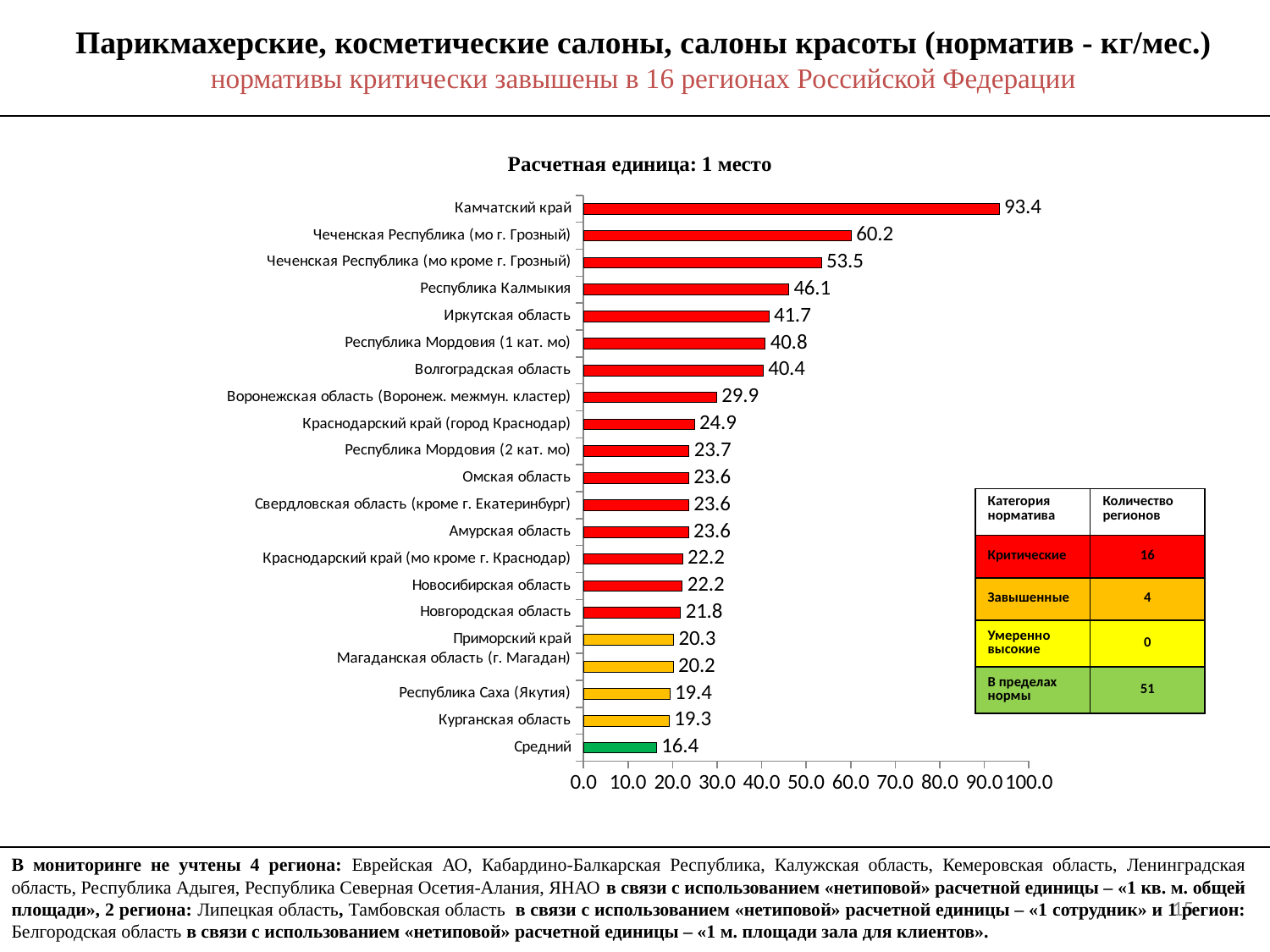
What is the value for Республика Калмыкия? 46.1 What is the value for Камчатский край? 93.4 How many bars are plotted in the chart? 21 Which category has the lowest value? Средний What is the title of the chart? Расчетная единица: 1 место What kind of chart is shown on the slide? bar chart What is the difference between the values for Камчатский край and Чеченская Республика (мо г. Грозный)? 33.2 What is the value for Средний? 16.4 Which is larger: the value for Иркутская область or the value for Волгоградская область? Иркутская область What colour is the bar for Средний? green Is the value for Воронежская область (Воронеж. межмун. кластер) greater or less than 40.0? less Which category has the highest value? Камчатский край